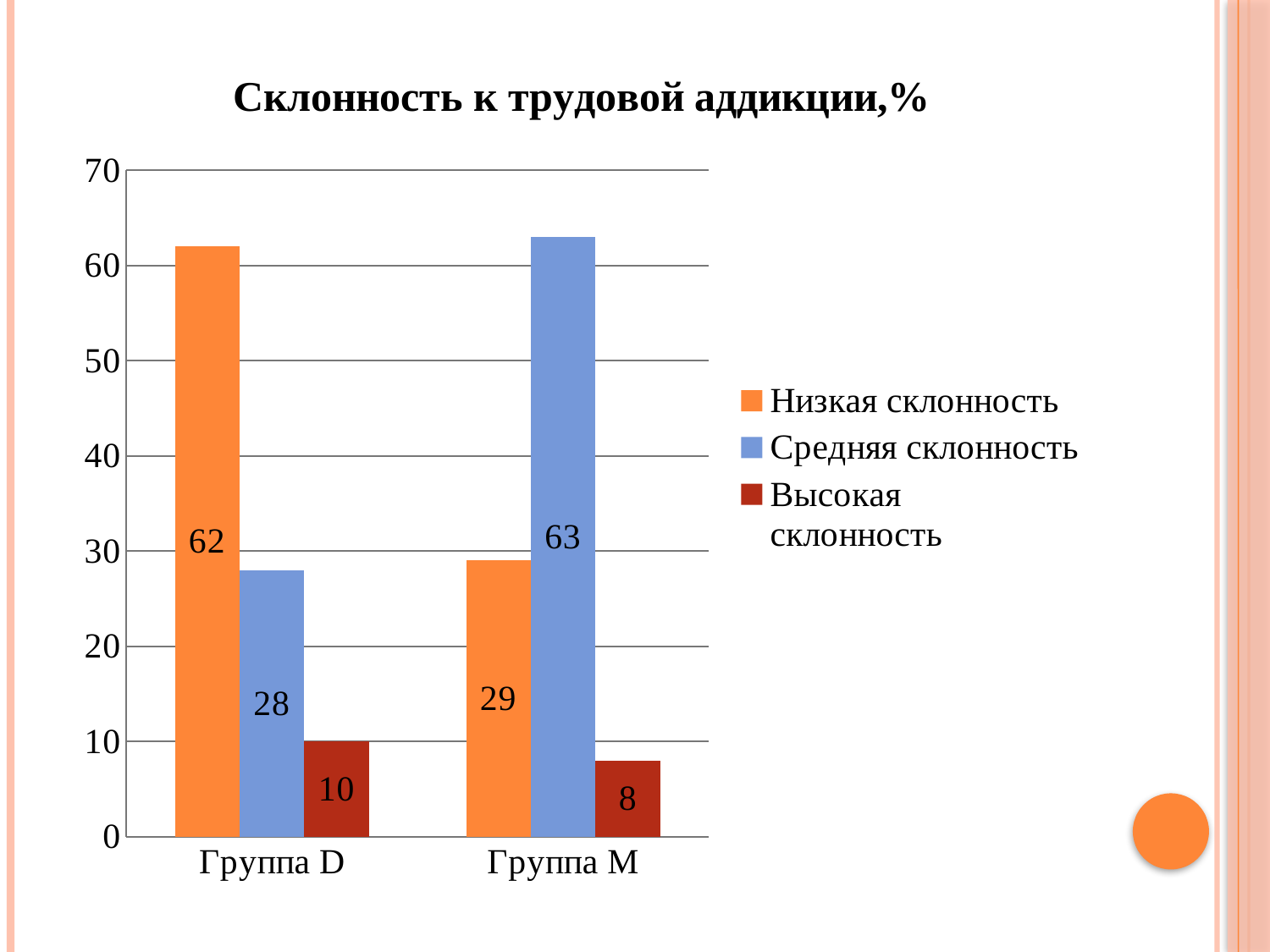
How many categories are shown on the x axis? 2 What is the difference between Низкая склонность in Группа D and Низкая склонность in Группа M? 33 What kind of chart is shown on the slide? Bar chart What is the value for Высокая склонность in Группа D? 10 Which is larger: Высокая склонность in Группа D or Высокая склонность in Группа M? Группа D Which series has the lowest value in Группа D? Высокая склонность How many series does the legend list? 3 What is the value for Низкая склонность in Группа M? 29 What is the title of the chart? Склонность к трудовой аддикции,% What is the value for Средняя склонность in Группа M? 63 What is the value for Низкая склонность in Группа D? 62 Which series has the highest value in Группа M? Средняя склонность